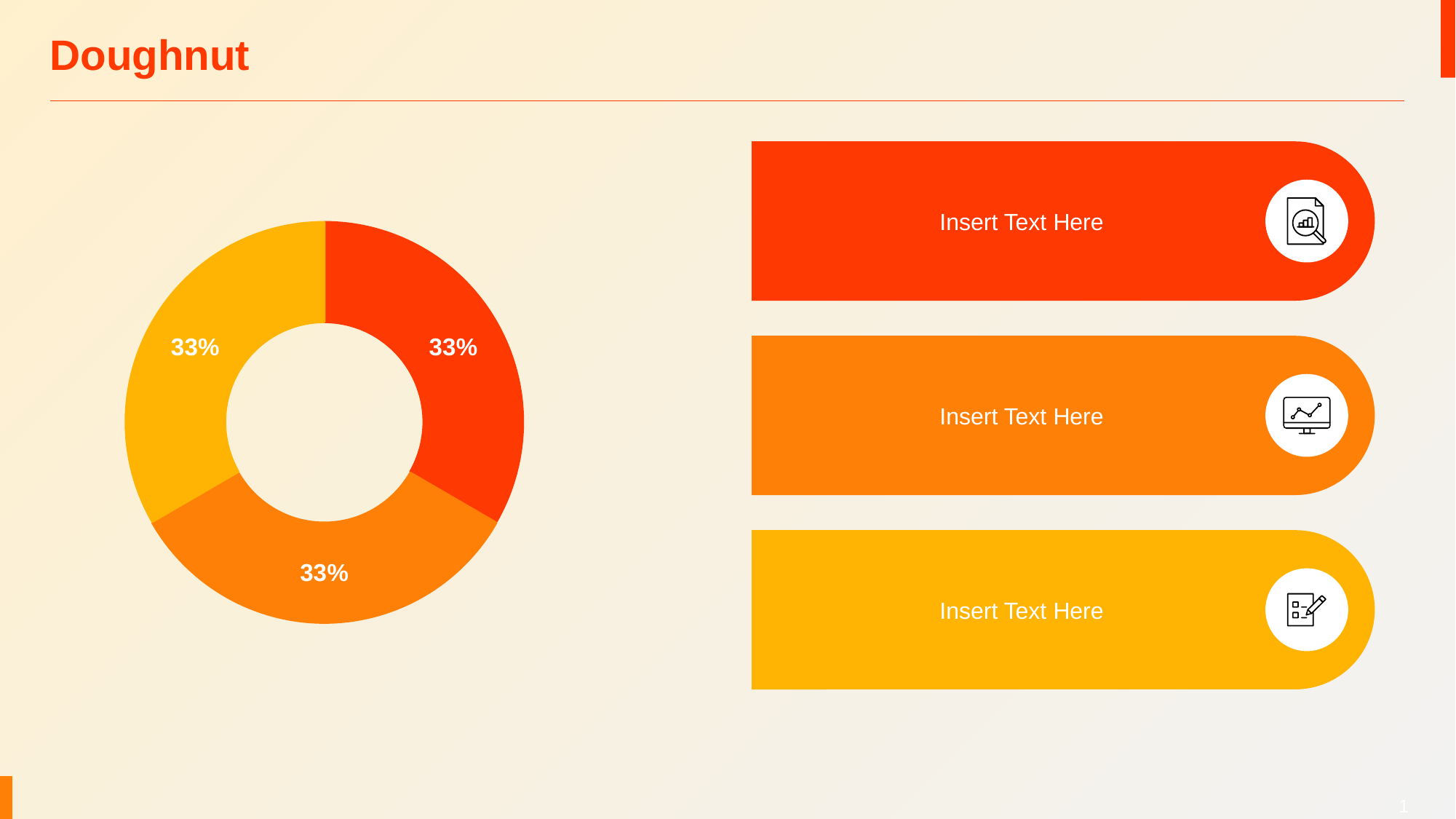
What is the title of the slide containing the doughnut chart? Doughnut Do all three slices of the doughnut chart show the same percentage? Yes What is the difference between the red slice and the yellow slice in the doughnut chart? 0% What share of the doughnut chart does the red slice represent? 33% What kind of chart is shown on the slide? Doughnut chart How many slices does the doughnut chart have? 3 What share of the doughnut chart does the orange slice represent? 33% Is the value of the yellow slice greater or less than 50%? less What three colours are used for the slices of the doughnut chart? Red, orange and yellow What share of the doughnut chart does the yellow slice represent? 33% Is the red slice of the doughnut chart larger than the orange slice, or are they equal? Equal